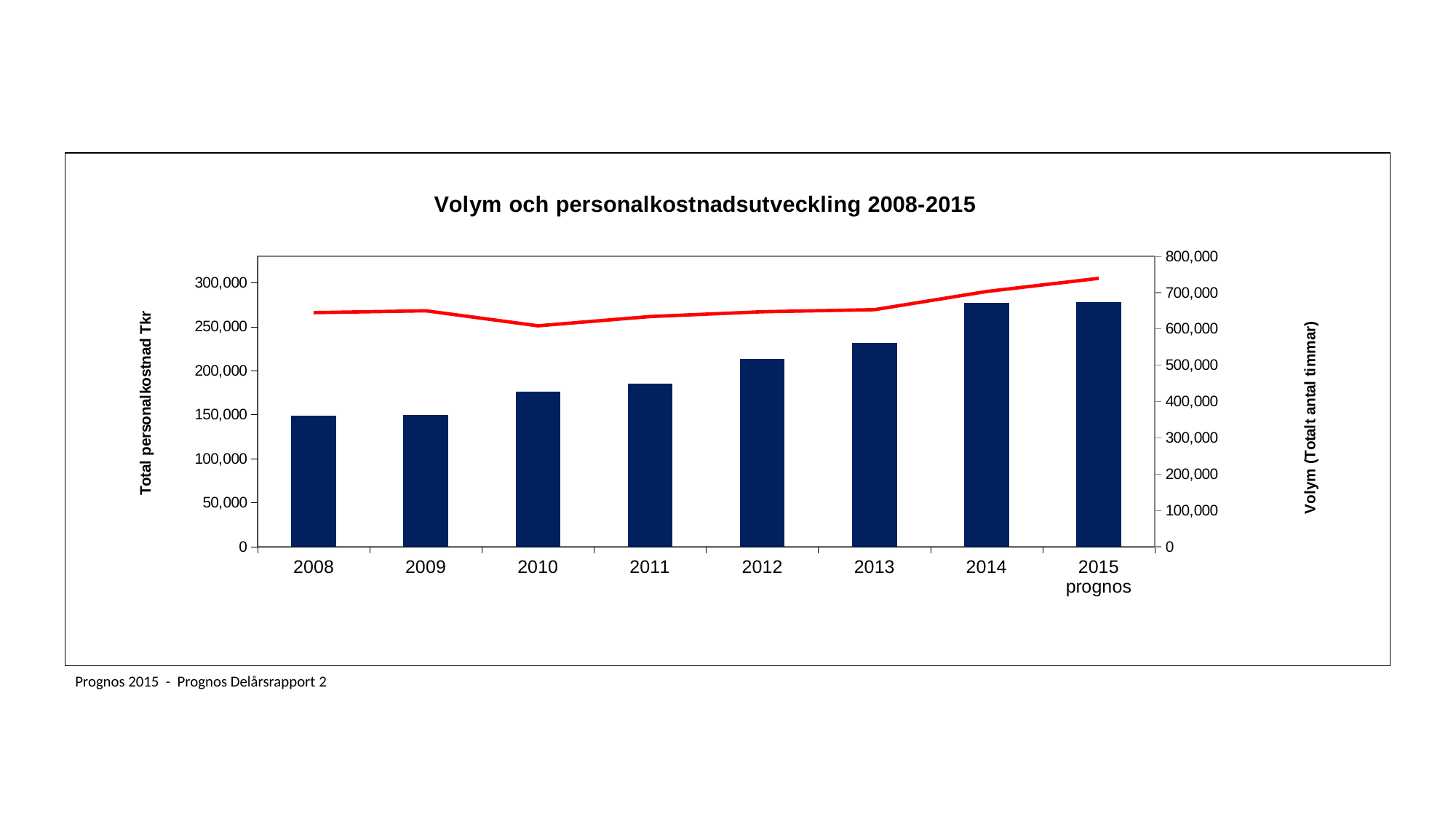
What is the title of the chart? Volym och personalkostnadsutveckling 2008-2015 Which bar is taller, 2013 or 2011? 2013 Is the bar value for 2012 greater or less than 200,000? greater Do the bar values generally rise or fall from 2008 to 2015 prognos? Rise Is the bar value for 2014 greater or less than 250,000? greater What is the label of the left vertical axis? Total personalkostnad Tkr What kind of chart is shown on the slide? A combined bar and line chart Which year has the lowest value on the red line (Volym)? 2010 How many years (categories) are shown on the x axis? 8